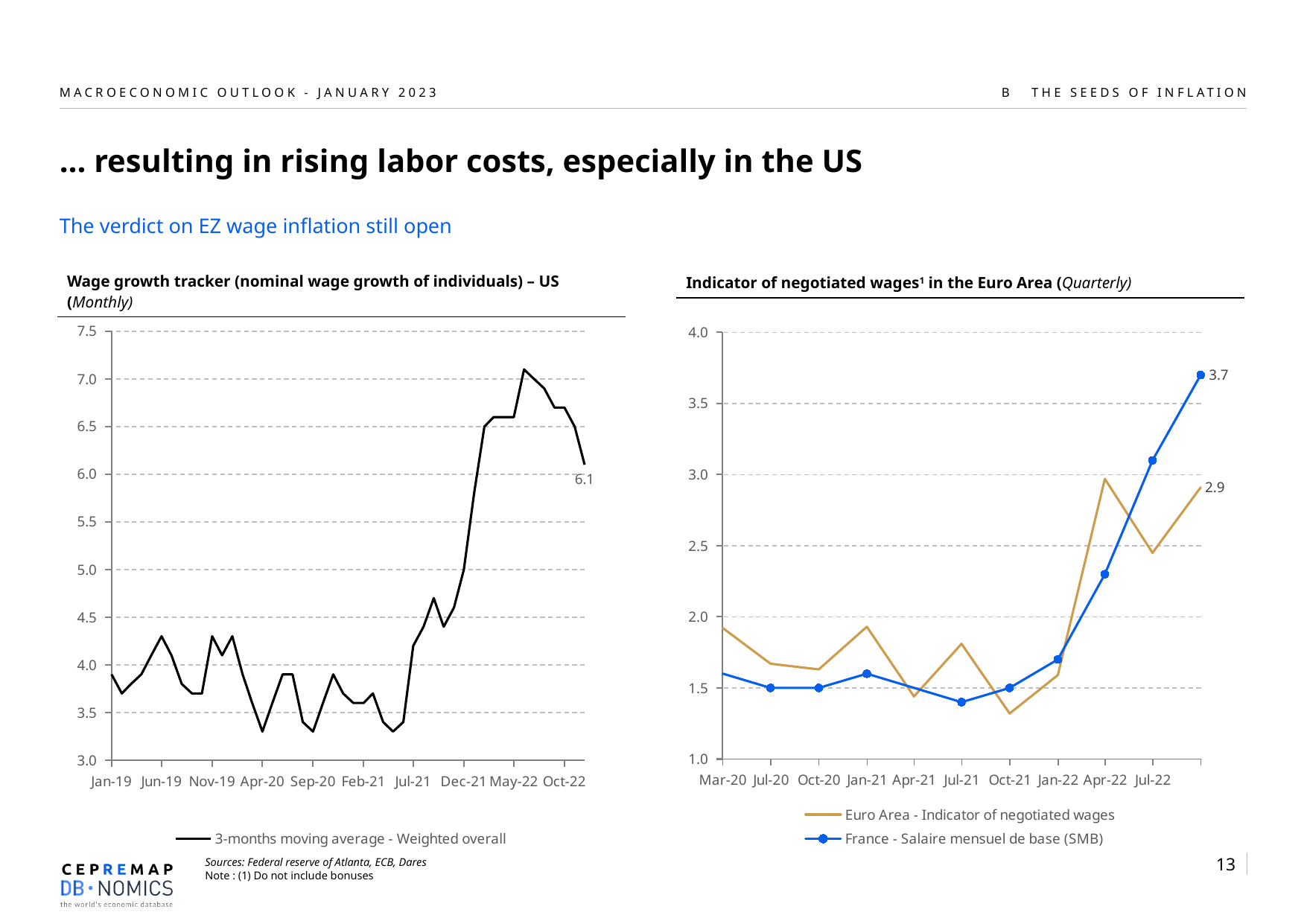
On the right chart (Indicator of negotiated wages in the Euro Area), which series has the higher final labeled value, France or the Euro Area? France On the left chart (Wage growth tracker – US), is the value at Apr-20 greater or less than 3.5? less On the right chart (Indicator of negotiated wages in the Euro Area), what is the difference between the last labeled values of France (3.7) and the Euro Area (2.9)? 0.8 On the right chart (Indicator of negotiated wages in the Euro Area), what is the last labeled value for France - Salaire mensuel de base (SMB)? 3.7 On the right chart (Indicator of negotiated wages in the Euro Area), is the Euro Area value at Oct-21 greater or less than 1.5? less What is the legend entry of the left chart (Wage growth tracker – US)? 3-months moving average - Weighted overall On the left chart (Wage growth tracker – US), what is the value printed at the end of the line? 6.1 How many series does the legend of the left chart (Wage growth tracker – US) list? 1 What kind of chart is the left chart, 'Wage growth tracker (nominal wage growth of individuals) – US'? Line chart How many series does the legend of the right chart (Indicator of negotiated wages in the Euro Area) list? 2 On the right chart (Indicator of negotiated wages in the Euro Area), what is the last labeled value for Euro Area - Indicator of negotiated wages? 2.9 On the right chart (Indicator of negotiated wages in the Euro Area), does the France series rise or fall from Jan-22 to the last point? rise